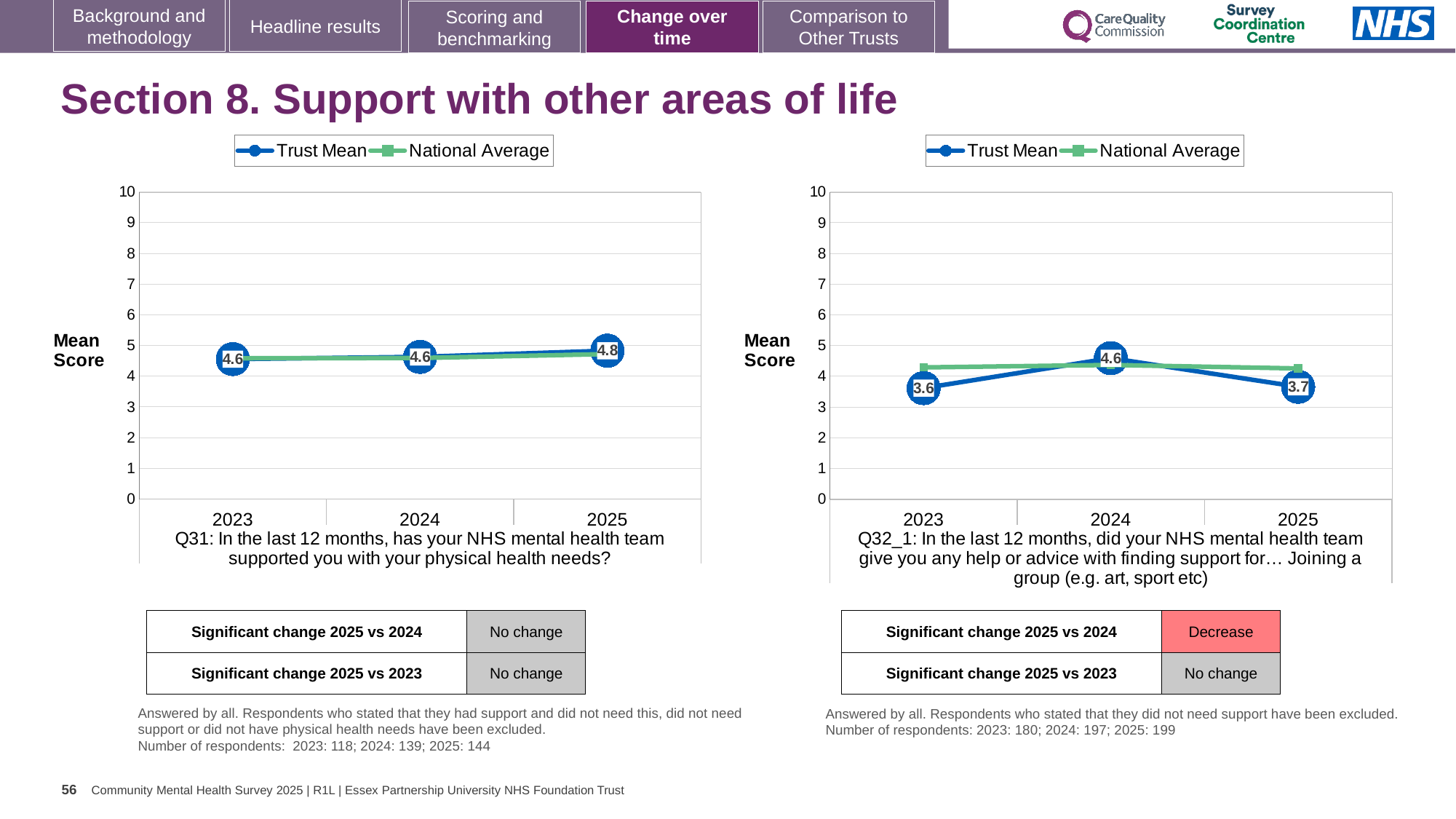
What kind of chart is the right chart (Q32_1)? line chart How many series does the legend of the left chart (Q31) list? 2 On the left chart (Q31), does the Trust Mean rise or fall from 2024 to 2025? rise On the right chart (Q32_1), is the Trust Mean for 2025 greater or less than 4? less On the right chart (Q32_1), which year has the lowest Trust Mean? 2023 On the right chart (Q32_1), what is the difference between the Trust Mean in 2024 and in 2025? 0.9 On the right chart (Q32_1), what is the Trust Mean for 2023? 3.6 On the right chart (Q32_1), which year has the highest Trust Mean? 2024 On the left chart (Q31), what is the Trust Mean for 2025? 4.8 On the right chart (Q32_1), what is the Trust Mean for 2024? 4.6 On the left chart (Q31), what is the difference between the Trust Mean in 2025 and in 2024? 0.2 On the left chart (Q31), what is the Trust Mean for 2023? 4.6